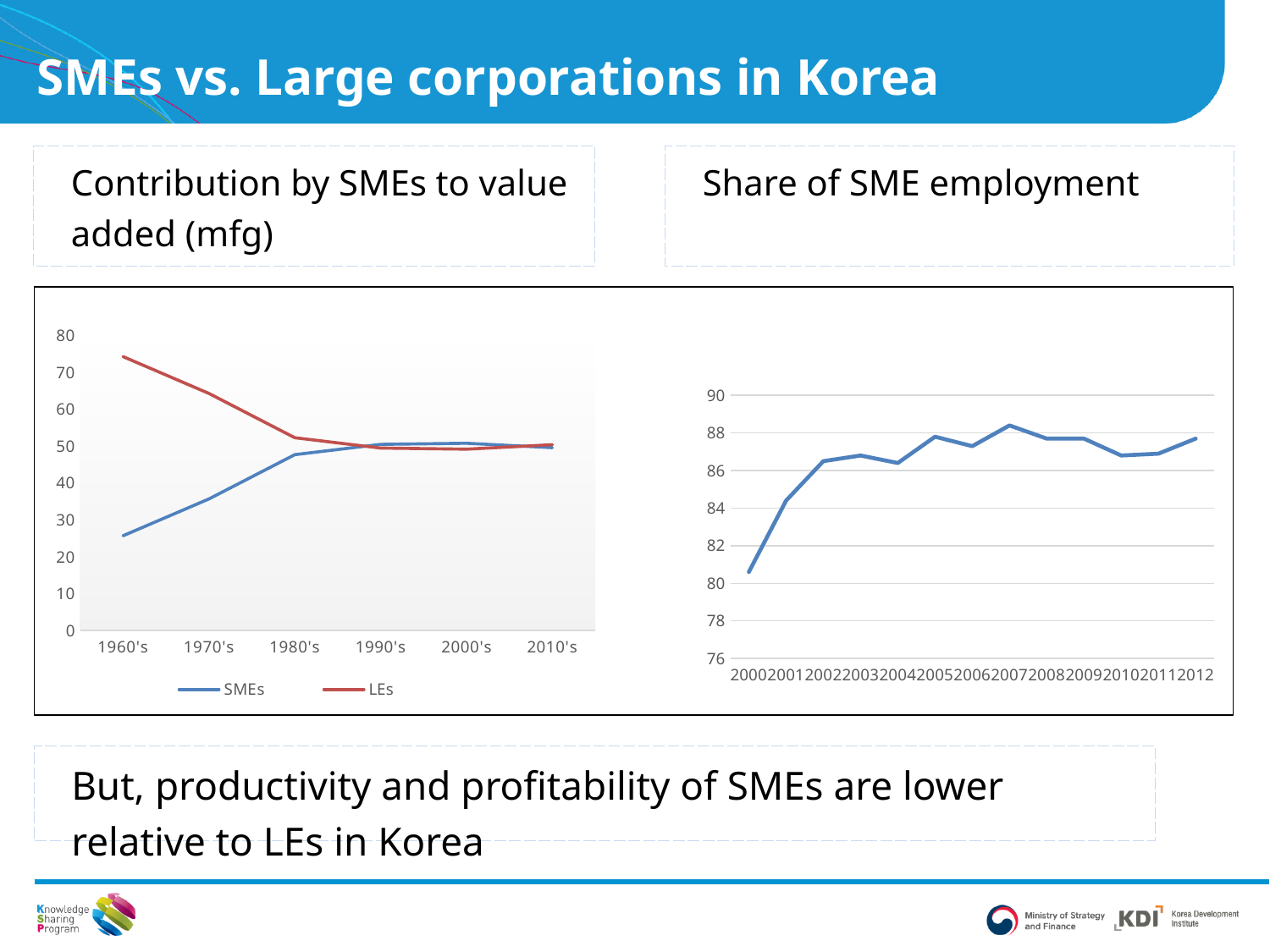
How many decade categories are shown on the x axis of the 'Contribution by SMEs to value added (mfg)' chart? 6 In the 'Share of SME employment' chart, which year has the lowest value? 2000 In the 'Contribution by SMEs to value added (mfg)' chart, which series has the larger value in the 1960's, SMEs or LEs? LEs In the 'Contribution by SMEs to value added (mfg)' chart, is the SMEs value for the 1960's greater or less than 30? less What kind of chart is the 'Contribution by SMEs to value added (mfg)' chart? line chart In the 'Contribution by SMEs to value added (mfg)' chart, is the LEs value for the 1960's greater or less than 70? greater In the 'Contribution by SMEs to value added (mfg)' chart, does the SMEs line rise or fall from the 1960's to the 2010's? rise In the 'Share of SME employment' chart, is the value for 2000 greater or less than 82? less How many years are plotted on the 'Share of SME employment' chart? 13 In the 'Contribution by SMEs to value added (mfg)' chart, does the LEs line rise or fall from the 1960's to the 2010's? fall How many series does the legend of the 'Contribution by SMEs to value added (mfg)' chart list? 2 In the 'Contribution by SMEs to value added (mfg)' chart, in which decade is the LEs value highest? 1960's